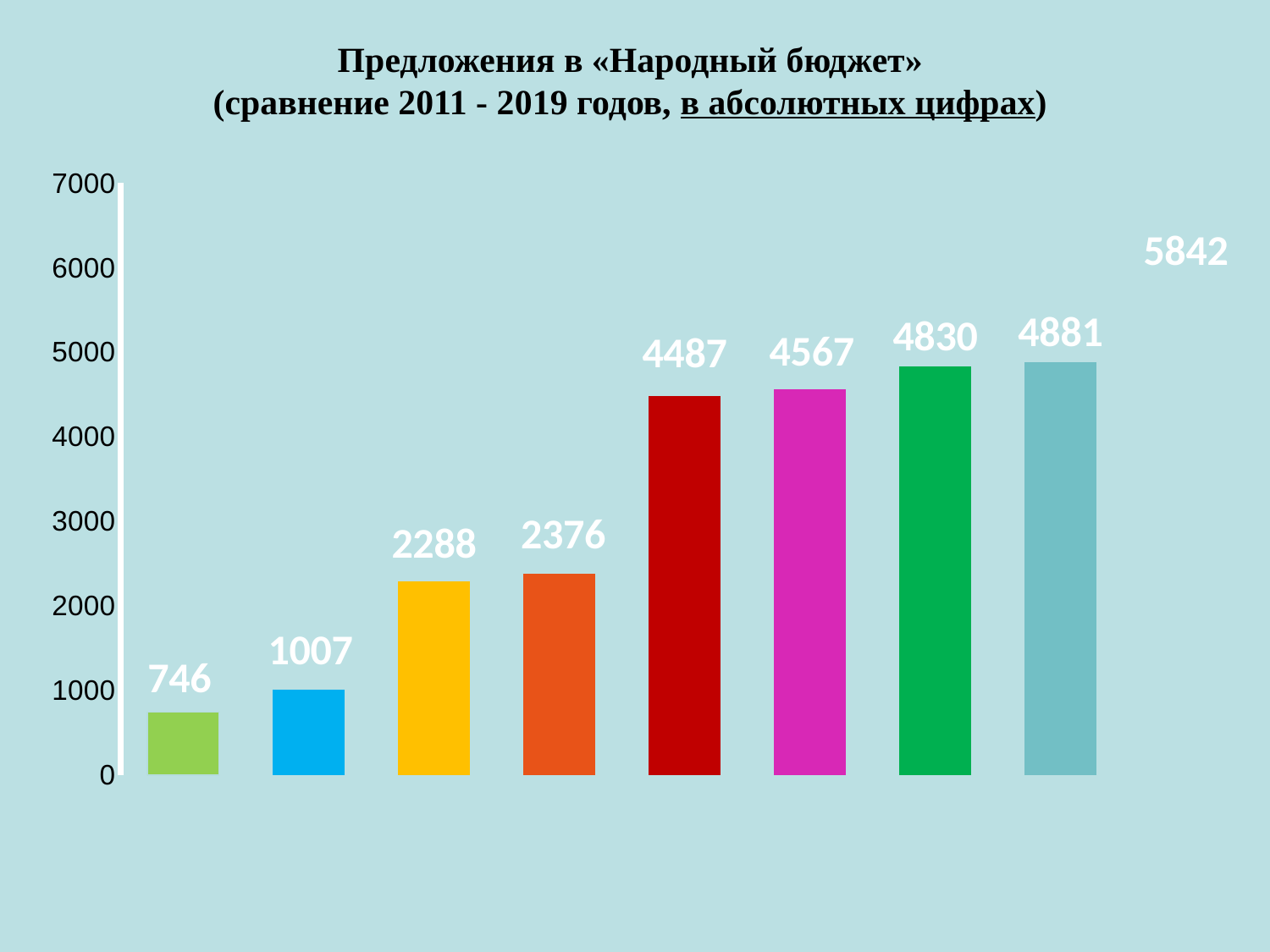
What is the largest value printed on the chart? 5842 What is the value printed above the rightmost (teal) bar? 4881 What is the value printed above the leftmost (light green) bar? 746 What is the value printed above the blue bar, second from the left? 1007 What is the value printed above the orange bar? 2376 What is the value printed above the magenta bar? 4567 What is the difference between the values of the teal bar (4881) and the dark green bar (4830)? 51 What is the value printed above the dark red bar? 4487 Do the bar values rise or fall from left to right across the chart? rise What is the value printed above the yellow bar? 2288 What kind of chart is shown on the slide? bar chart What is the smallest value printed on the chart? 746